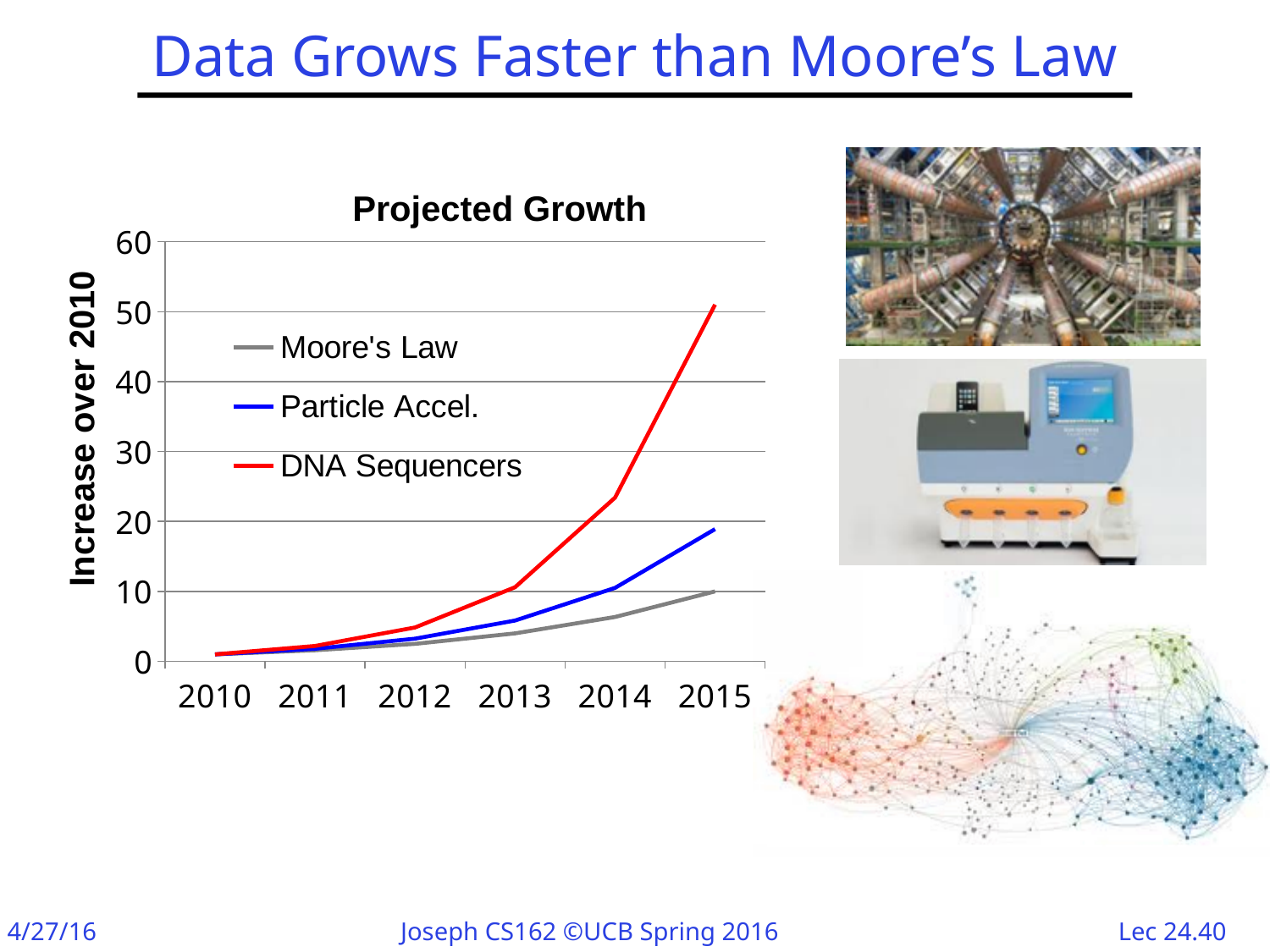
Do the values for DNA Sequencers rise or fall from 2010 to 2015? rise What is the label on the y axis of the Projected Growth chart? Increase over 2010 Which series has the highest value in 2015 in the Projected Growth chart? DNA Sequencers Is the value for DNA Sequencers in 2015 greater or less than 40? greater How many years are shown on the x axis of the Projected Growth chart? 6 Which series has the lowest value in 2015 in the Projected Growth chart? Moore's Law Is the value for Moore's Law in 2014 greater or less than 10? less In 2015, which is larger: the value for Particle Accel. or the value for Moore's Law? Particle Accel. What kind of chart is shown on the slide? line chart How many series does the legend of the Projected Growth chart list? 3 Is the value for Particle Accel. in 2015 greater or less than 20? less